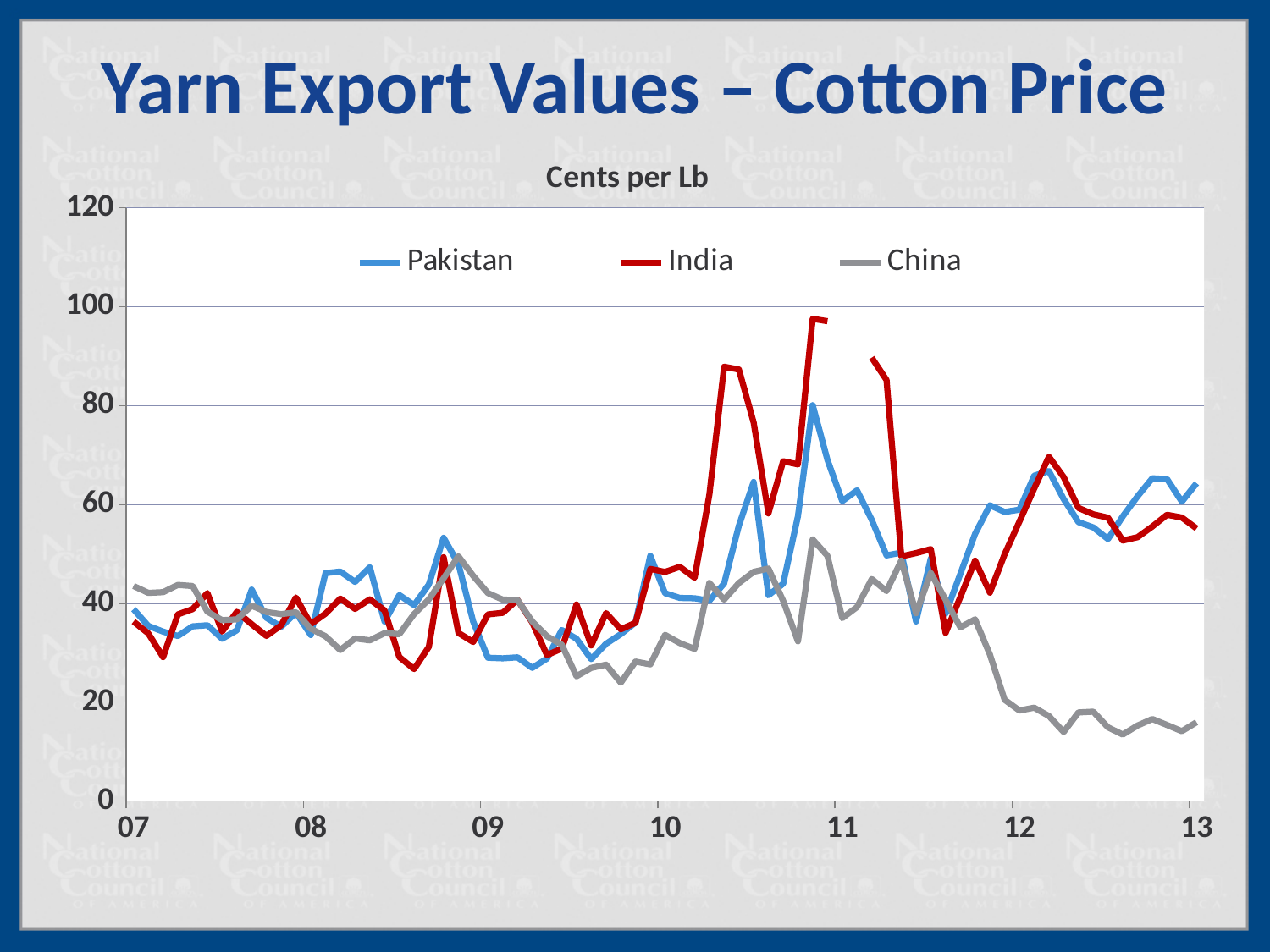
Which series has the lowest value at the end of the chart (13)? China How many year labels are shown on the x axis? 7 Which series reaches the highest value on the chart? India Is the value for Pakistan at 13 greater or less than 60? greater Is the peak value for India greater or less than 80? greater What is the title of the slide? Yarn Export Values – Cotton Price Does the China series rise or fall between 11 and 13? fall What unit label appears above the chart? Cents per Lb At 13, which is larger, the value for Pakistan or the value for China? Pakistan What kind of chart is shown on the slide? line chart How many series does the legend list? 3 Is the value for China at 13 greater or less than 20? less